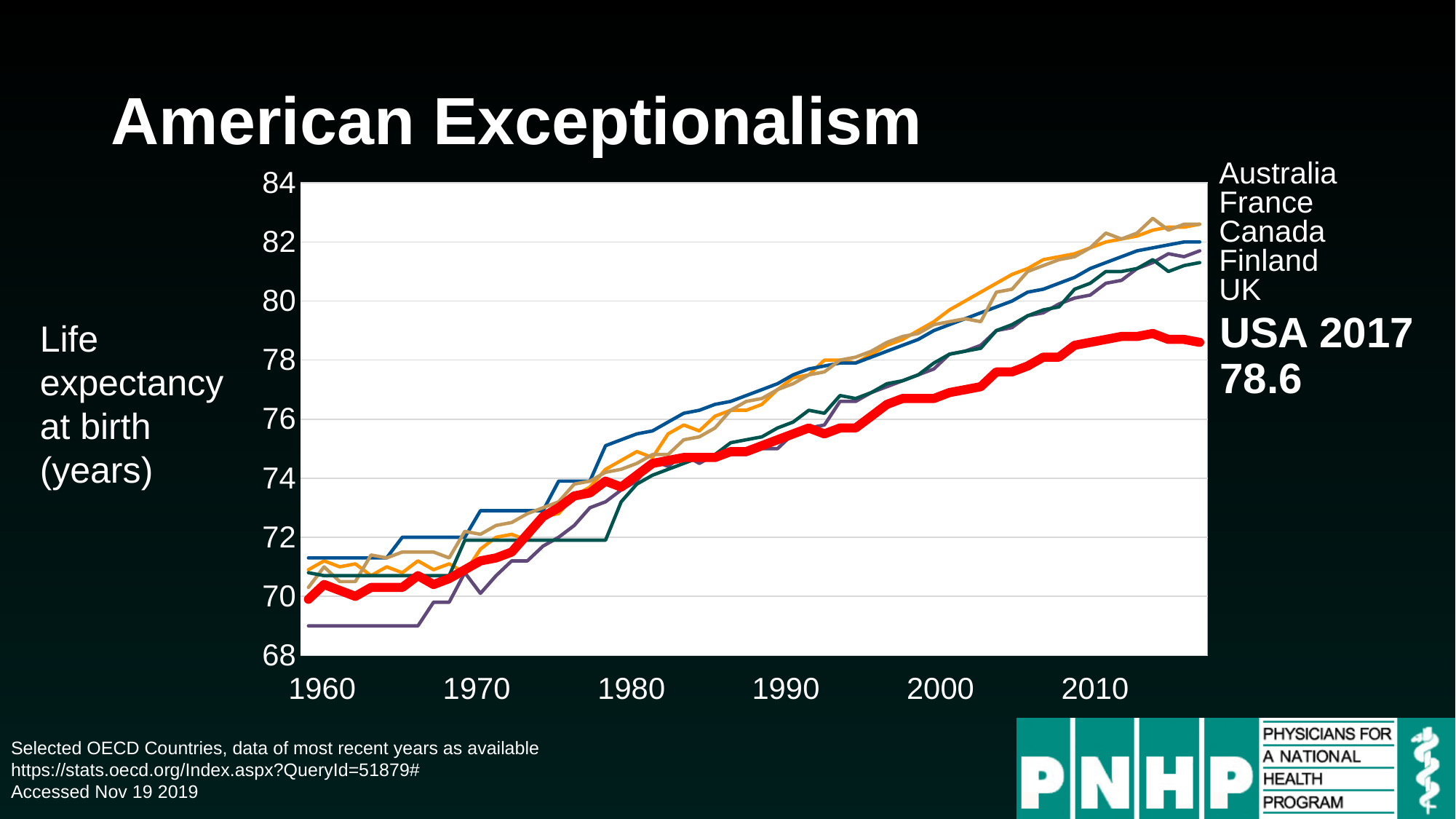
What is the life expectancy at birth for the USA in 2017 according to the chart? 78.6 Is the USA value for 2017 greater or less than 80? less What quantity does the y axis of the chart measure? Life expectancy at birth (years) Is the USA value around 2000 greater or less than 76? greater Is the USA value around 1990 greater or less than 76? less What kind of chart is shown on the slide? line chart What is the title of the slide containing the chart? American Exceptionalism In 2017, is the USA line higher or lower than the lines for the other countries? lower Does the USA line rise or fall overall from 1960 to 2017? rise How many countries are listed in the legend of the chart? 6 Which country has the lowest life expectancy at the end of the chart (2017)? USA